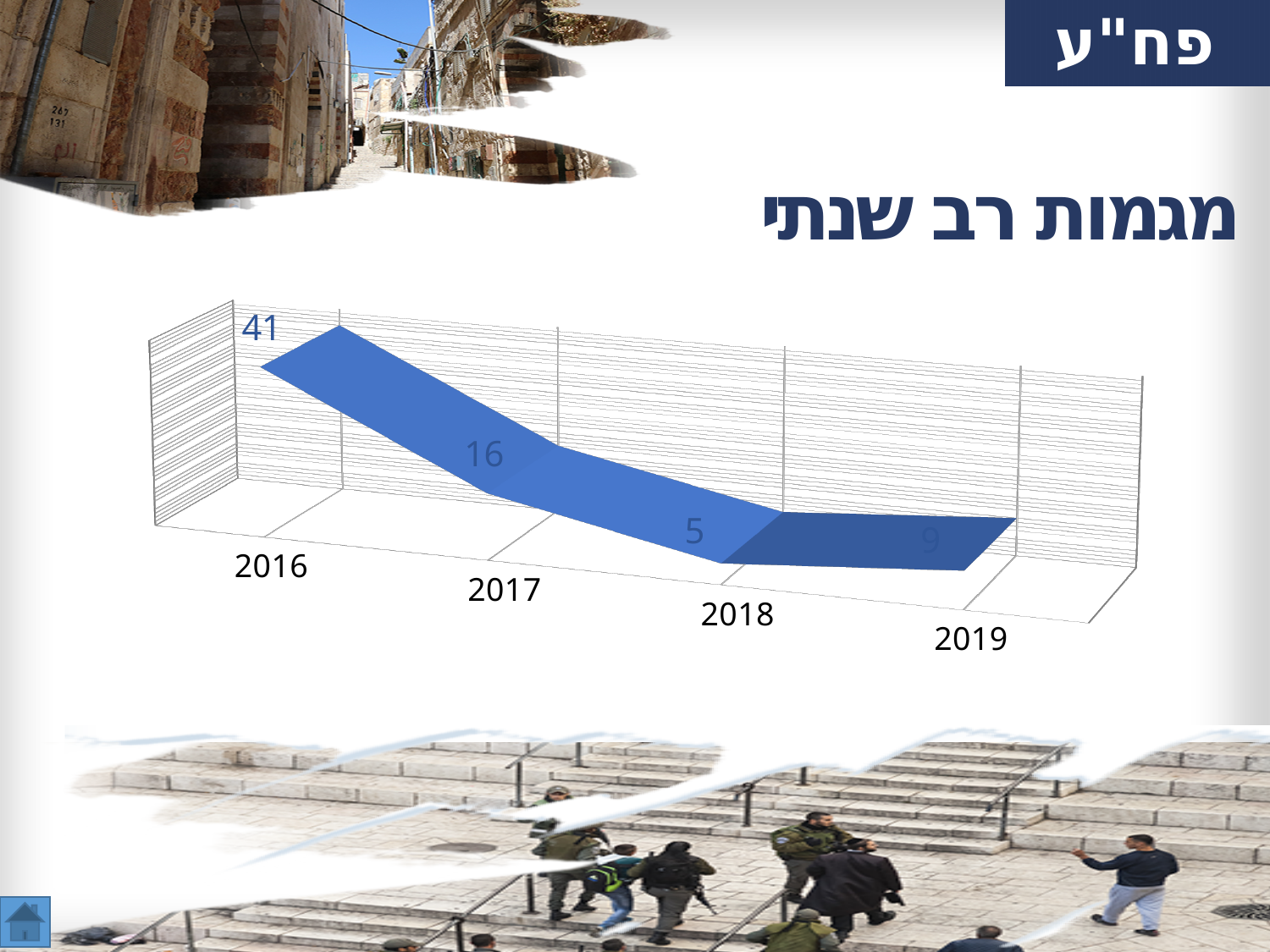
What is the difference between the values for 2019 and 2018? 4 What is the value for 2018? 5 Which year has the lowest value? 2018 What kind of chart is shown on the slide? line chart What is the value for 2019? 9 What is the value for 2017? 16 Which year has the highest value? 2016 Do the values rise or fall from 2016 to 2018? fall What is the difference between the values for 2016 and 2017? 25 How many years are shown on the x axis? 4 Which is larger, the value for 2017 or the value for 2019? 2017 What is the value for 2016? 41